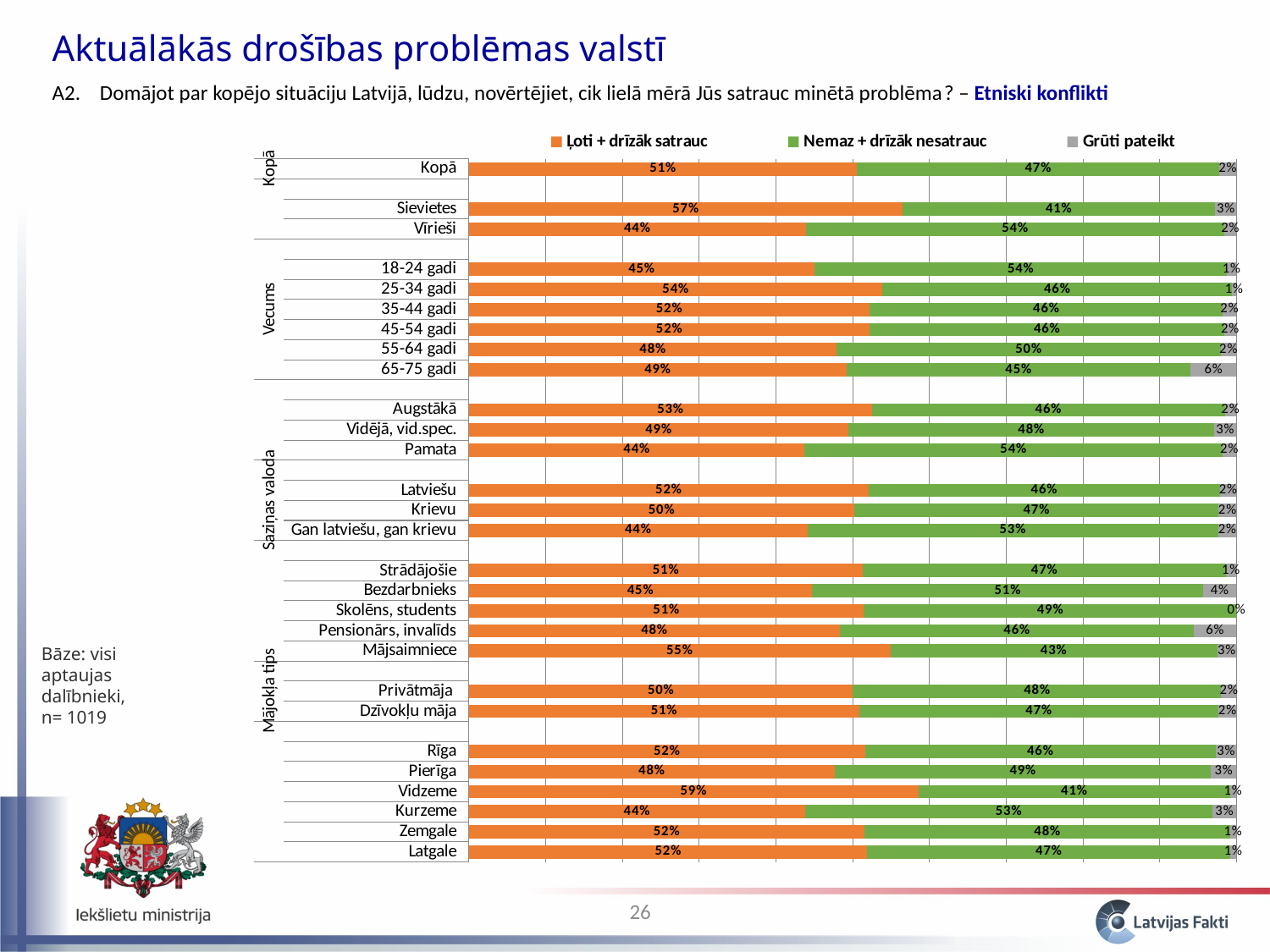
What type of chart is shown on the slide? stacked bar chart What is the value of "Ļoti + drīzāk satrauc" for Kopā? 51% What is the difference between the "Ļoti + drīzāk satrauc" values for Sievietes and Vīrieši? 13% How many categories are plotted in the chart? 28 What is the value of "Grūti pateikt" for Skolēns, students? 0% Which legend entry is shown in grey? Grūti pateikt Which is larger for Bezdarbnieks: "Ļoti + drīzāk satrauc" or "Nemaz + drīzāk nesatrauc"? Nemaz + drīzāk nesatrauc Which category has the highest value for "Ļoti + drīzāk satrauc"? Vidzeme What is the value of "Grūti pateikt" for 65-75 gadi? 6% How many series does the legend list? 3 What is the value of "Nemaz + drīzāk nesatrauc" for Sievietes? 41% What is the value of "Nemaz + drīzāk nesatrauc" for Kurzeme? 53%